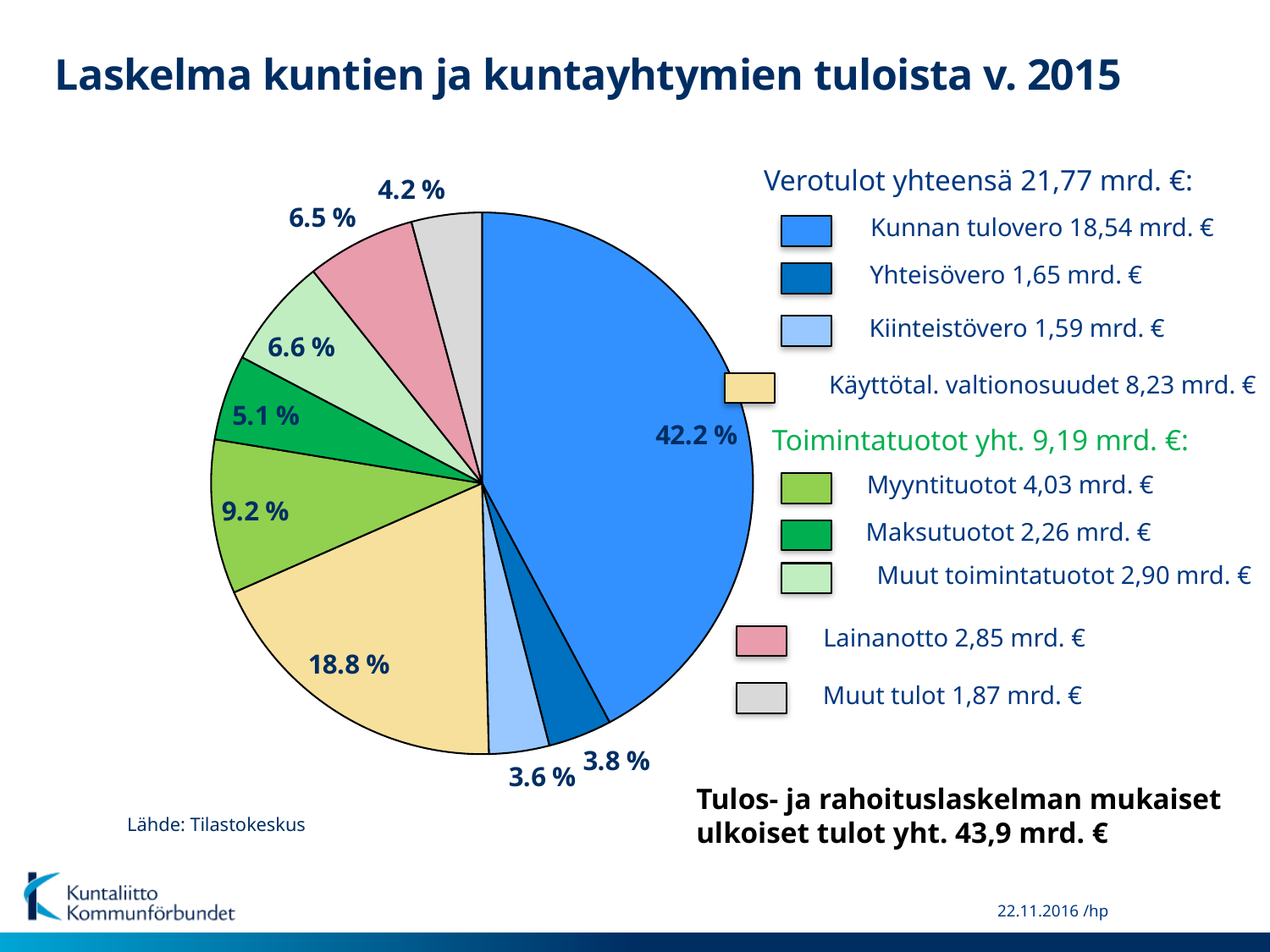
According to the legend, what is the amount for Yhteisövero? 1,65 mrd. € What percentage is shown for Lainanotto in the pie chart? 6.5 % How many slices does the pie chart have? 9 Which category has the largest slice of the pie chart? Kunnan tulovero What kind of chart is shown on the slide? pie chart What is the difference in percentage points between the Myyntituotot slice and the Maksutuotot slice? 4.1 What percentage is shown for Muut tulot in the pie chart? 4.2 % What total is given for Verotulot yhteensä on the slide? 21,77 mrd. € Which category has the smallest slice of the pie chart? Kiinteistövero Which slice is larger, Myyntituotot or Muut tulot? Myyntituotot What percentage is shown for Käyttötal. valtionosuudet in the pie chart? 18.8 % What share of the pie does Kunnan tulovero represent? 42.2 %